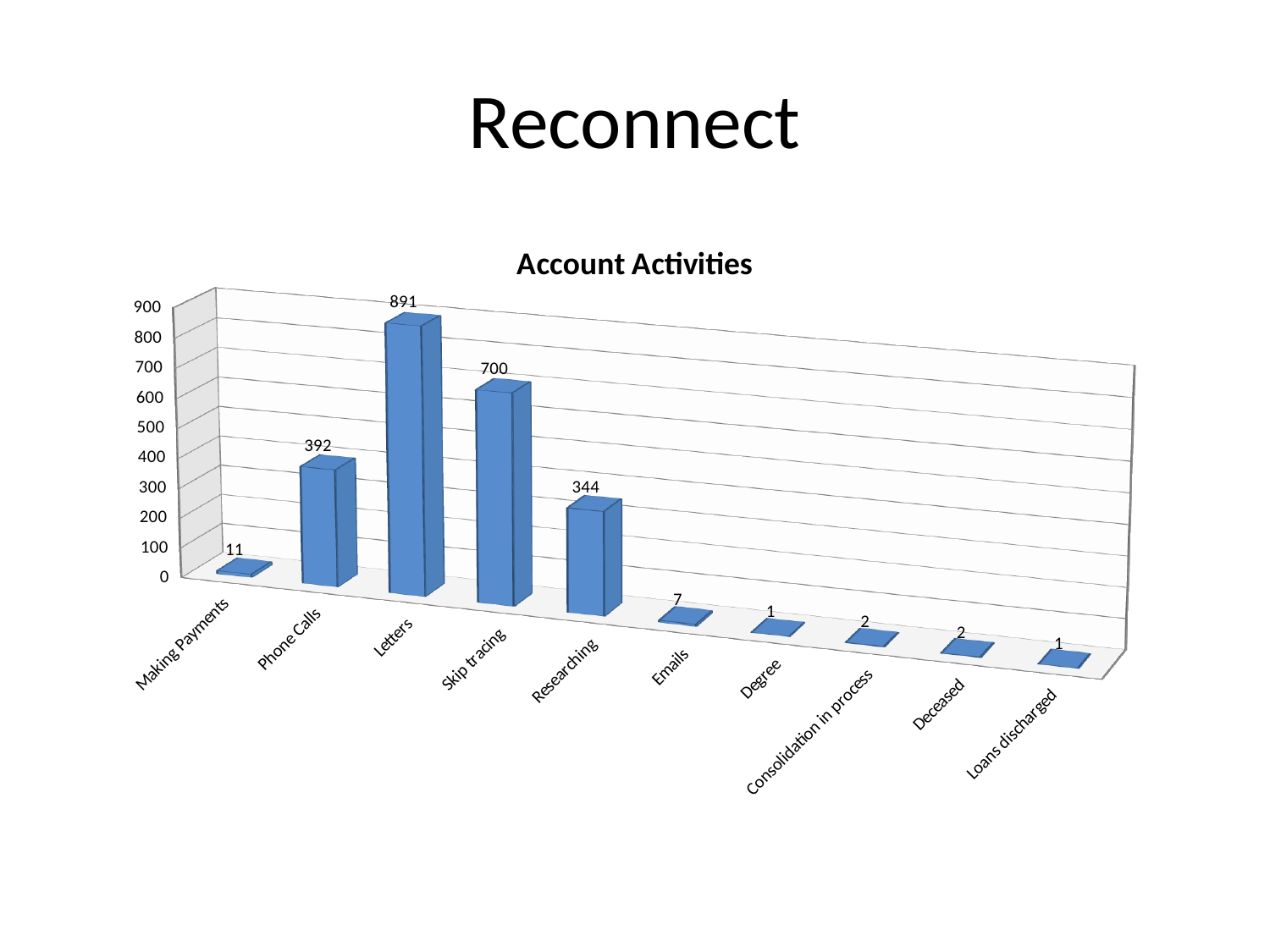
How many categories are shown on the x axis? 10 What kind of chart is shown? bar chart What is the title of the chart? Account Activities What is the value for Phone Calls? 392 What is the value for Letters? 891 Which category has the highest value? Letters What is the value for Making Payments? 11 Which is larger, the value for Phone Calls or the value for Researching? Phone Calls What is the difference between the values for Letters and Skip tracing? 191 What is the value for Emails? 7 Is the value for Skip tracing greater or less than 600? greater What is the value for Researching? 344